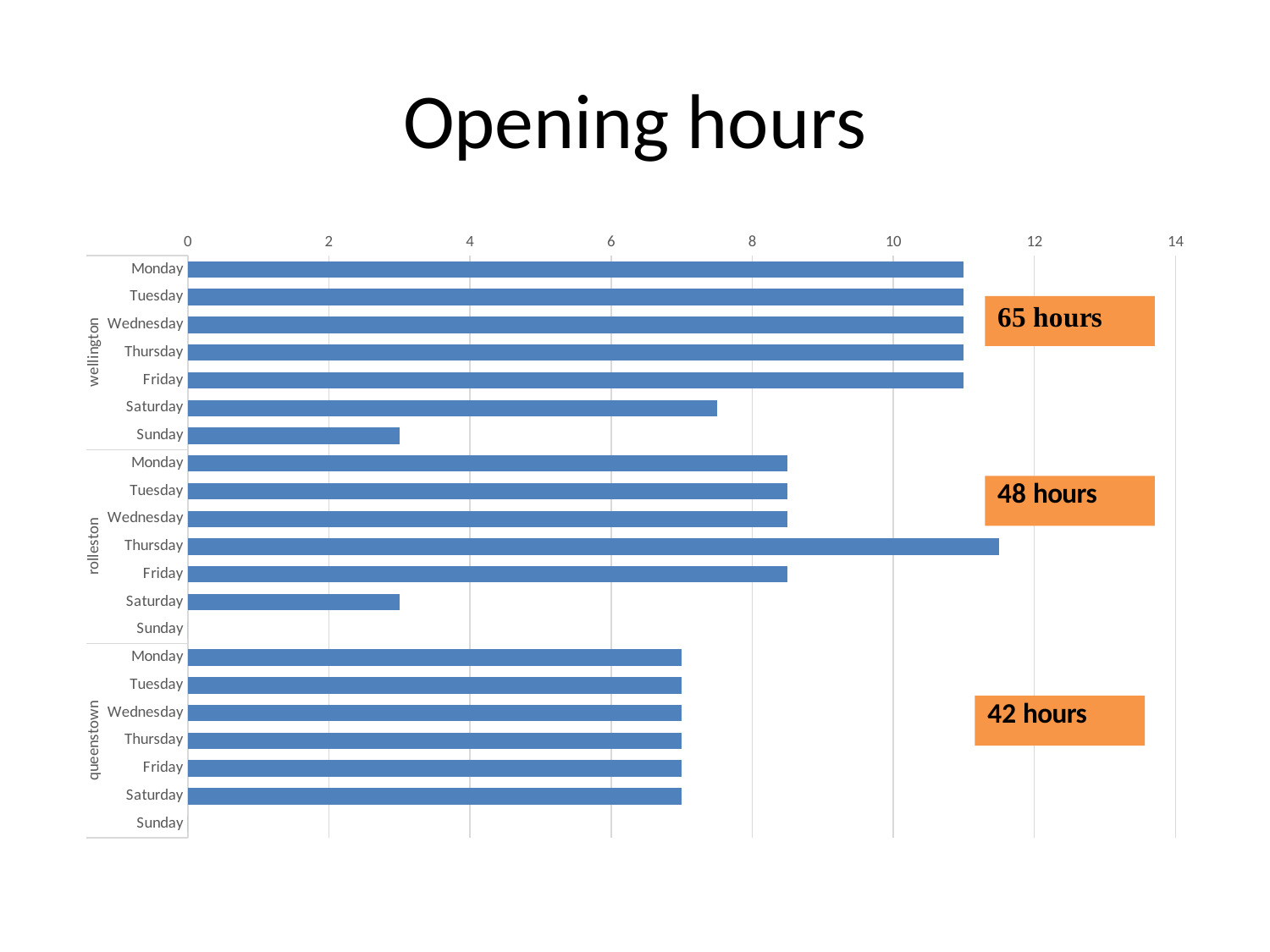
Which day has the shortest bar in the wellington group? Sunday What is the value for Sunday in queenstown? 0 What kind of chart is shown on the slide? bar chart How many day categories are plotted in total across all groups? 21 What weekly total is shown in the orange box next to the wellington group? 65 hours How many location groups are shown on the vertical axis? 3 Which is larger: the value for Saturday in wellington or the value for Saturday in rolleston? Saturday in wellington Which day has the longest bar in the rolleston group? Thursday Is the value for Monday in queenstown greater or less than 8? less Is the value for Monday in wellington greater or less than 10? greater Is the value for Sunday in wellington greater or less than 4? less What is the title of the chart? Opening hours